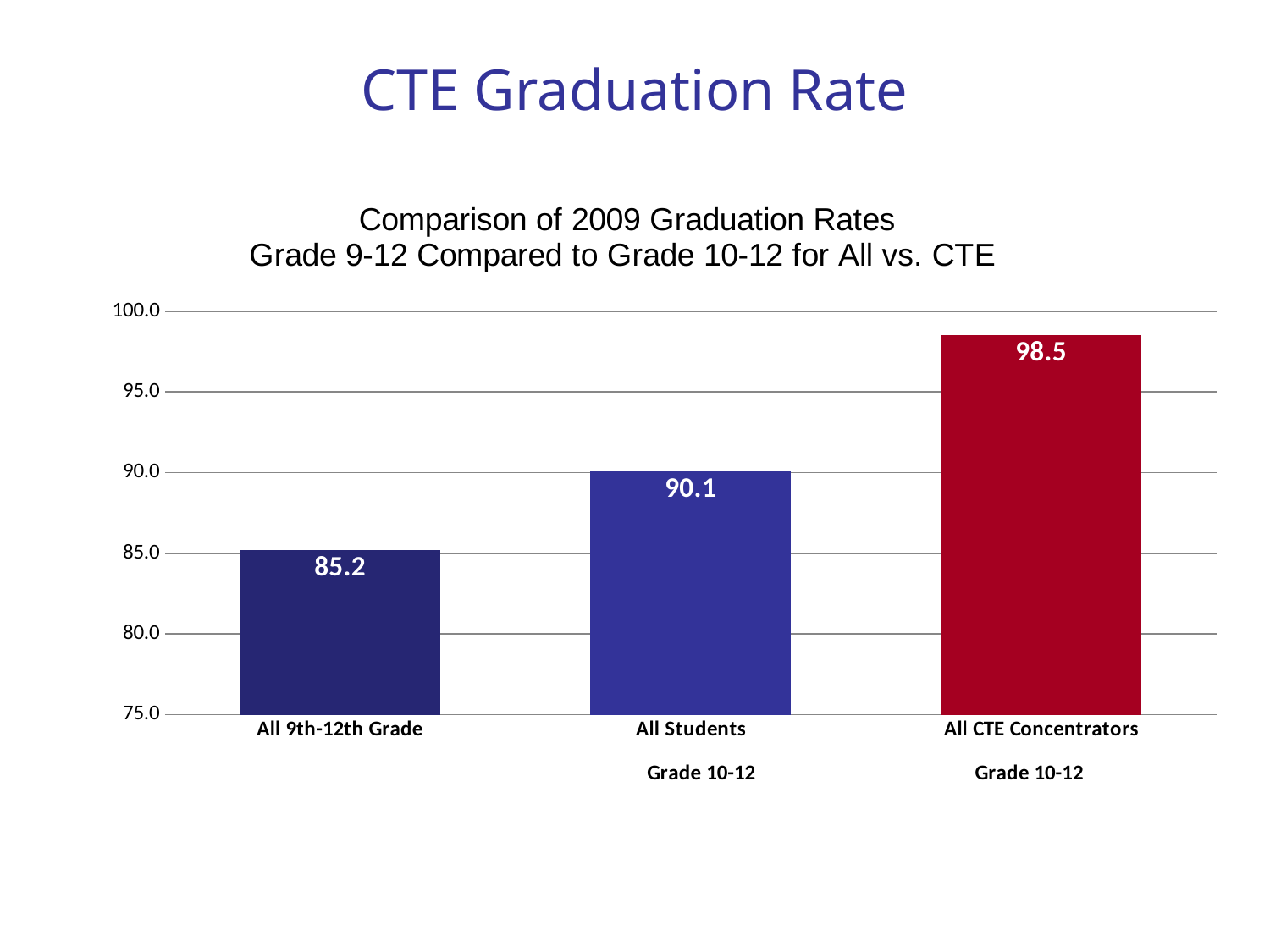
What kind of chart is shown on the slide? Bar chart Which is larger, the graduation rate for All Students Grade 10-12 or for All 9th-12th Grade? All Students Grade 10-12 What is the graduation rate for All 9th-12th Grade? 85.2 What is the title of the chart? Comparison of 2009 Graduation Rates Grade 9-12 Compared to Grade 10-12 for All vs. CTE What is the graduation rate for All CTE Concentrators Grade 10-12? 98.5 Is the value for All CTE Concentrators Grade 10-12 greater or less than 95.0? greater What is the difference between the graduation rates for All Students Grade 10-12 and All 9th-12th Grade? 4.9 What is the graduation rate for All Students Grade 10-12? 90.1 How many categories are shown in the chart? 3 Which category has the highest graduation rate? All CTE Concentrators Grade 10-12 Which category has the lowest graduation rate? All 9th-12th Grade What is the difference between the graduation rates for All CTE Concentrators Grade 10-12 and All Students Grade 10-12? 8.4